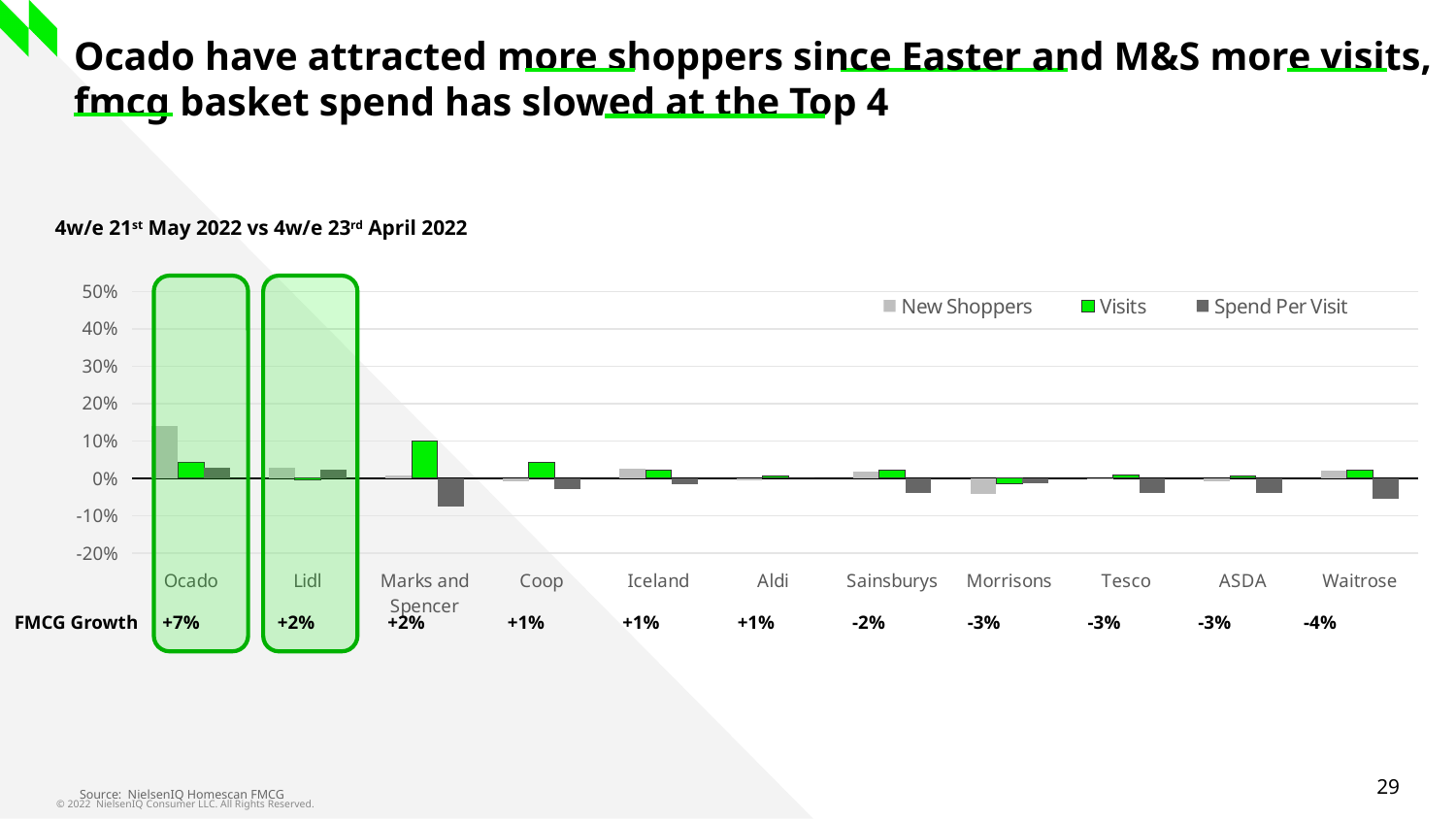
Which retailer has the lowest FMCG Growth figure shown below the chart? Waitrose Which retailer has the highest New Shoppers bar? Ocado How many series does the chart legend list? 3 How many retailers are shown along the x axis of the chart? 11 What is the FMCG Growth figure shown for Waitrose? -4% What is the FMCG Growth figure shown for Ocado? +7% Which series are listed in the chart legend? New Shoppers, Visits, Spend Per Visit Is the New Shoppers value for Ocado greater or less than 10%? greater What kind of chart is shown on the slide? bar chart Which two retailers are highlighted with green boxes on the chart? Ocado and Lidl Which retailer has the highest Visits bar? Marks and Spencer Is the Spend Per Visit value for Marks and Spencer greater or less than 0%? less